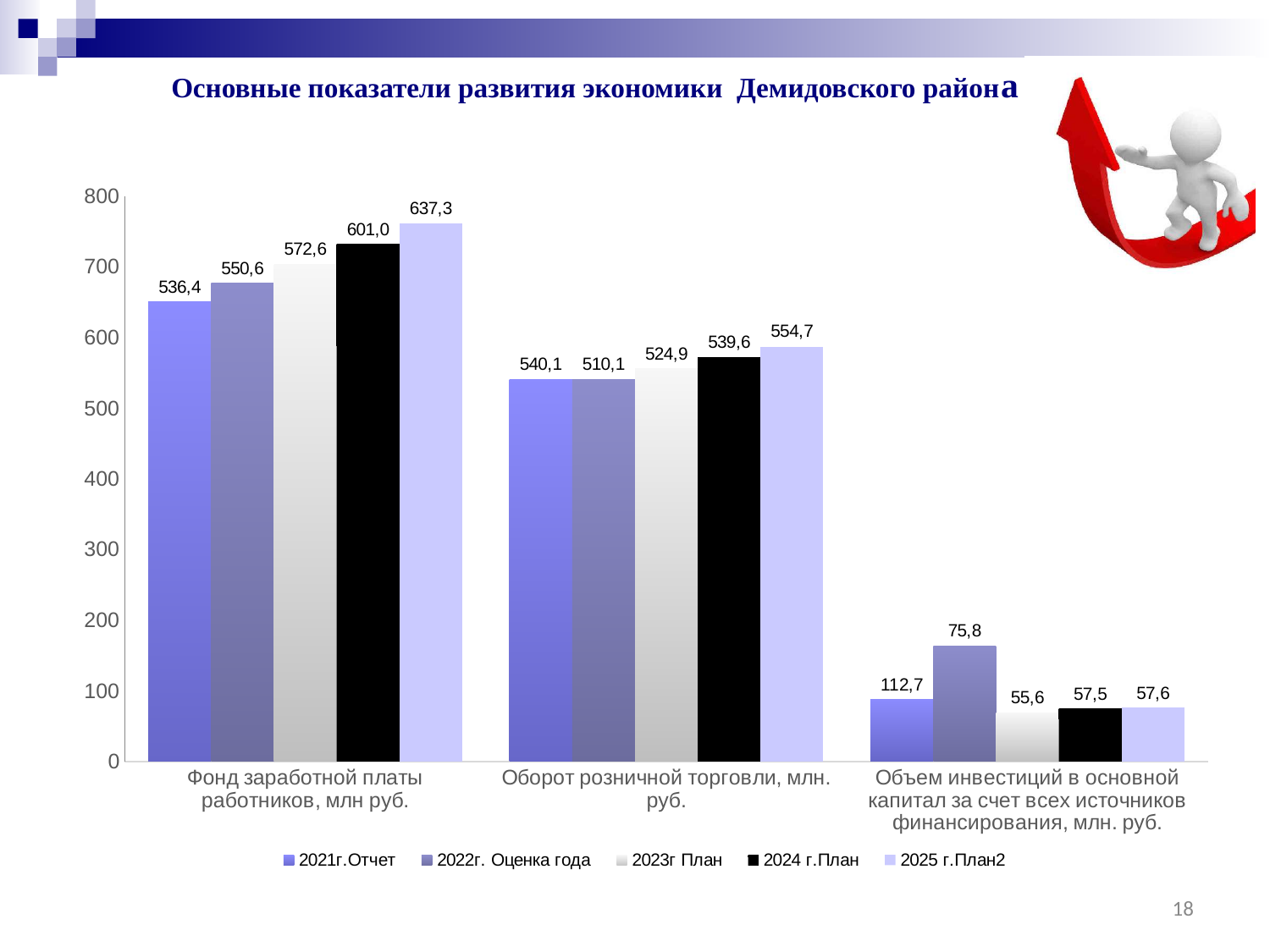
What kind of chart is shown on the slide? bar chart How many categories are shown on the x axis of the chart? 3 What is the value for 2021г.Отчет in the category Объем инвестиций в основной капитал за счет всех источников финансирования, млн. руб.? 112,7 Is the value for 2023г План in the category Объем инвестиций в основной капитал greater or less than 100? less What is the value for 2022г. Оценка года in the category Оборот розничной торговли, млн. руб.? 510,1 What is the difference between the 2025 г.План2 and 2021г.Отчет values for Фонд заработной платы работников, млн руб.? 100,9 What is the value for 2024 г.План in the category Фонд заработной платы работников, млн руб.? 601,0 Which series has the highest value in the category Фонд заработной платы работников, млн руб.? 2025 г.План2 What is the difference between the 2022г. Оценка года and 2023г План values for Объем инвестиций в основной капитал? 20,2 Which series has the lowest value in the category Оборот розничной торговли, млн. руб.? 2022г. Оценка года How many series does the legend list? 5 Which is larger for 2025 г.План2: Фонд заработной платы работников or Оборот розничной торговли? Фонд заработной платы работников